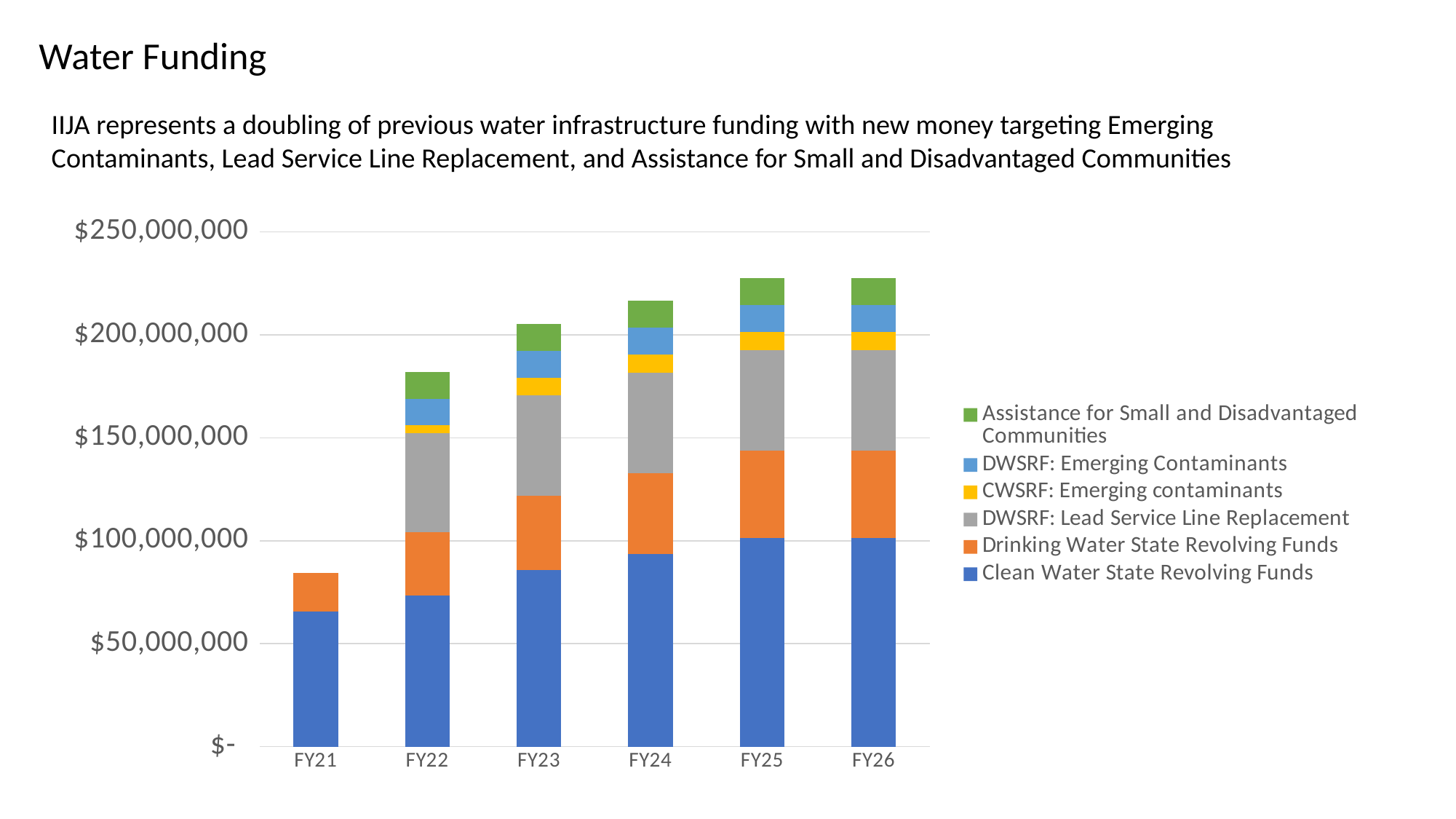
Is the Clean Water State Revolving Funds value for FY24 greater or less than $100,000,000? less How many series does the chart's legend list? 6 Is the total funding for FY22 greater or less than $150,000,000? greater Do the total funding bars generally rise or fall from FY21 to FY26? rise Which fiscal year has the lowest total funding bar? FY21 Is the total funding for FY21 greater or less than $100,000,000? less Which series is shown in green in the chart's legend? Assistance for Small and Disadvantaged Communities How many fiscal years are shown on the x axis of the chart? 6 Which has the larger total funding bar, FY21 or FY22? FY22 Which series forms the bottom (blue) segment of each stacked bar? Clean Water State Revolving Funds What kind of chart is shown on the slide? Stacked bar chart